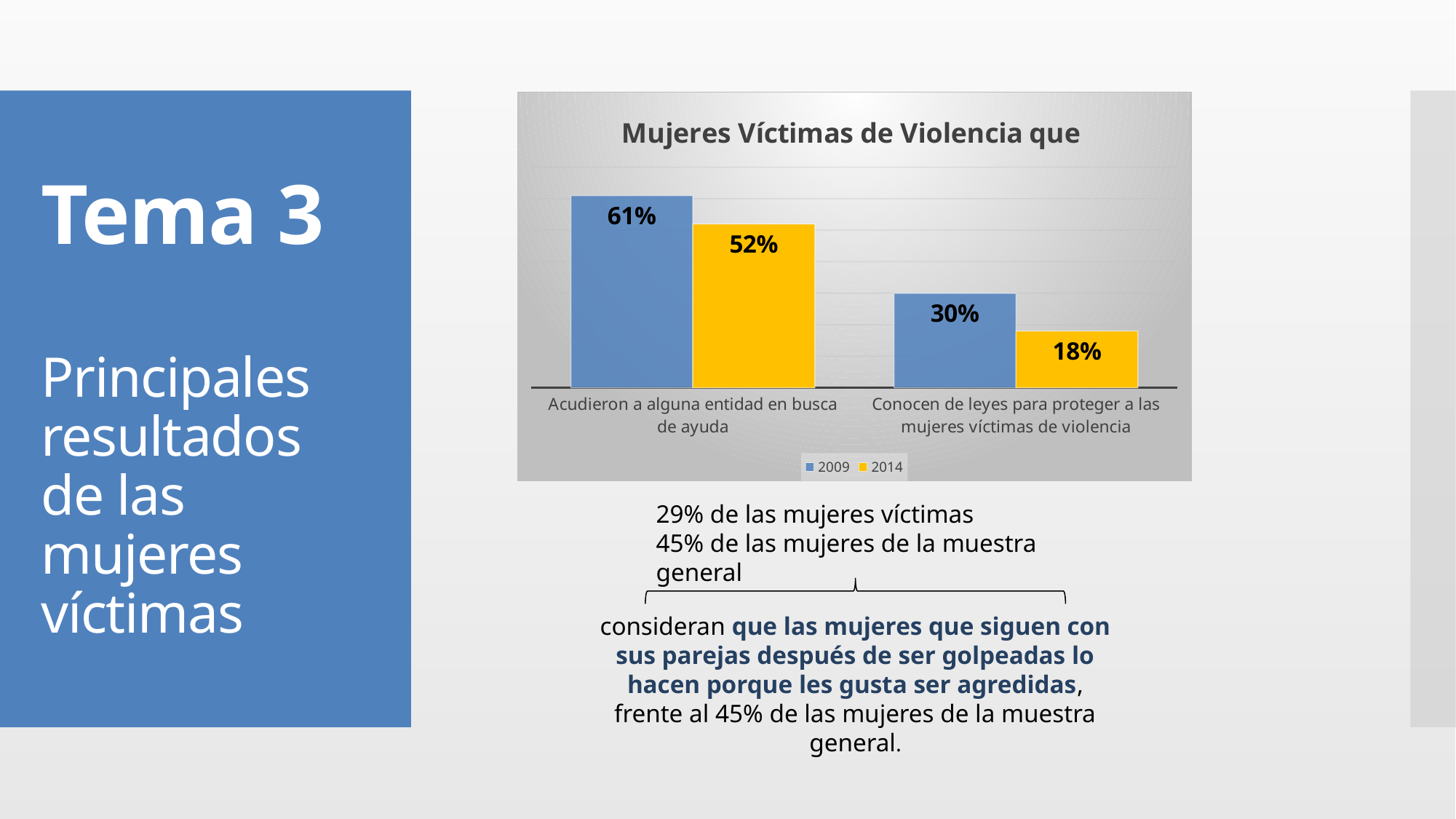
How many series does the legend list? 2 What is the difference between the 2009 and 2014 values for 'Acudieron a alguna entidad en busca de ayuda'? 9% Which is larger for 'Conocen de leyes para proteger a las mujeres víctimas de violencia': the 2009 value or the 2014 value? 2009 What is the difference between the 2009 and 2014 values for 'Conocen de leyes para proteger a las mujeres víctimas de violencia'? 12% What kind of chart is shown on the slide? Bar chart What is the 2009 value for 'Acudieron a alguna entidad en busca de ayuda'? 61% How many categories are shown on the x axis? 2 What is the 2014 value for 'Conocen de leyes para proteger a las mujeres víctimas de violencia'? 18% Which category has the lowest 2014 value? Conocen de leyes para proteger a las mujeres víctimas de violencia What is the 2014 value for 'Acudieron a alguna entidad en busca de ayuda'? 52% Which category has the highest 2009 value? Acudieron a alguna entidad en busca de ayuda What is the 2009 value for 'Conocen de leyes para proteger a las mujeres víctimas de violencia'? 30%